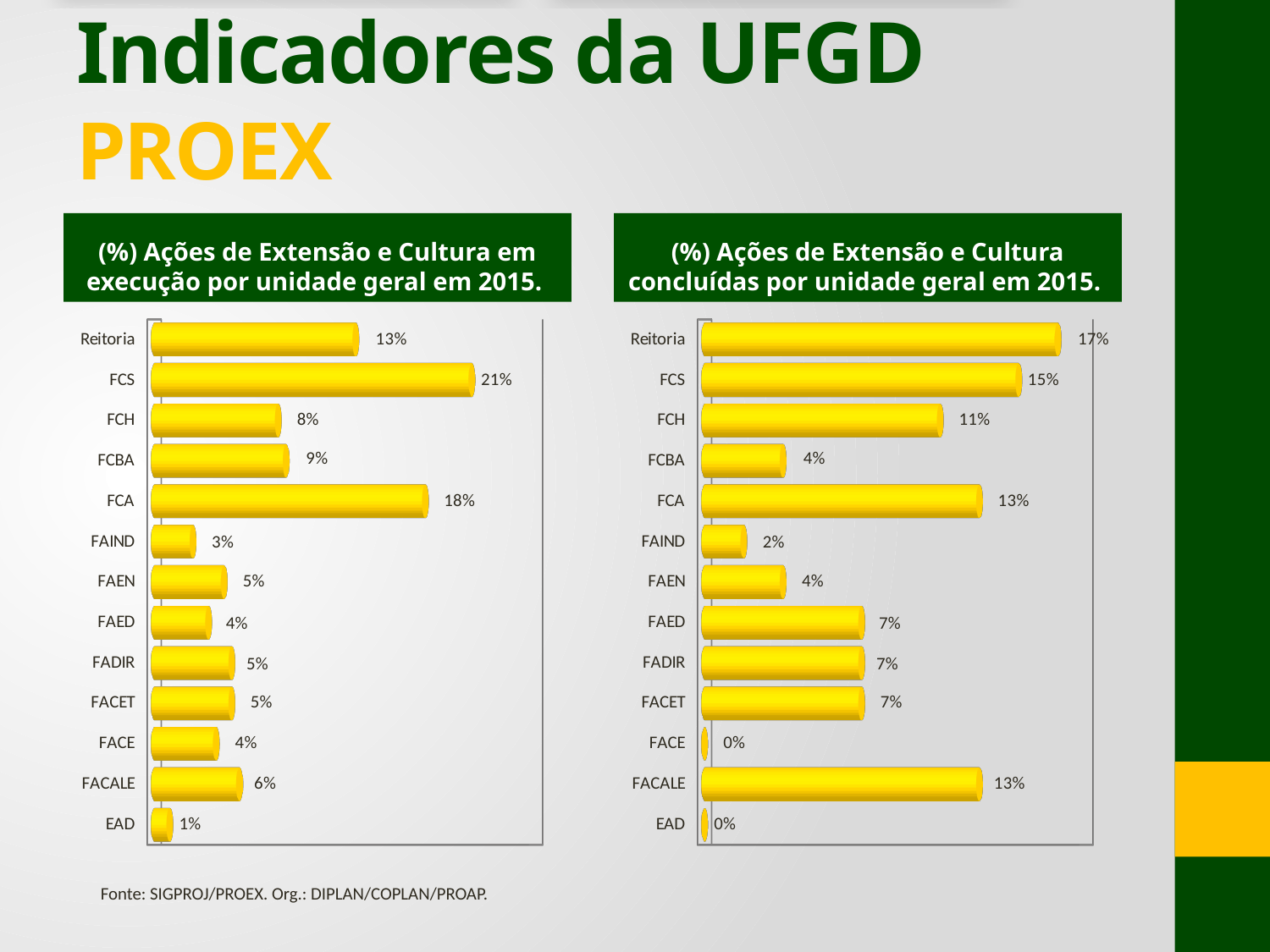
In the right chart (concluídas), which is larger, the value for FCA or the value for FCS? FCS In the left chart (em execução), which unit has the highest value? FCS What type of chart is the right chart (concluídas)? Bar chart In the right chart (concluídas), what is the difference between the values for Reitoria and FCBA? 13% In the right chart (concluídas), what is the value for FCH? 11% What is the title of the left chart? (%) Ações de Extensão e Cultura em execução por unidade geral em 2015. In the left chart (em execução), which unit has the lowest value? EAD In the left chart (em execução), which is larger, the value for FCBA or the value for FCH? FCBA How many units are shown in the left chart (em execução)? 13 In the left chart (em execução), what is the difference between the values for FCS and FCA? 3% In the right chart (concluídas), which unit has the highest value? Reitoria In the left chart (em execução), what is the value for FCS? 21%